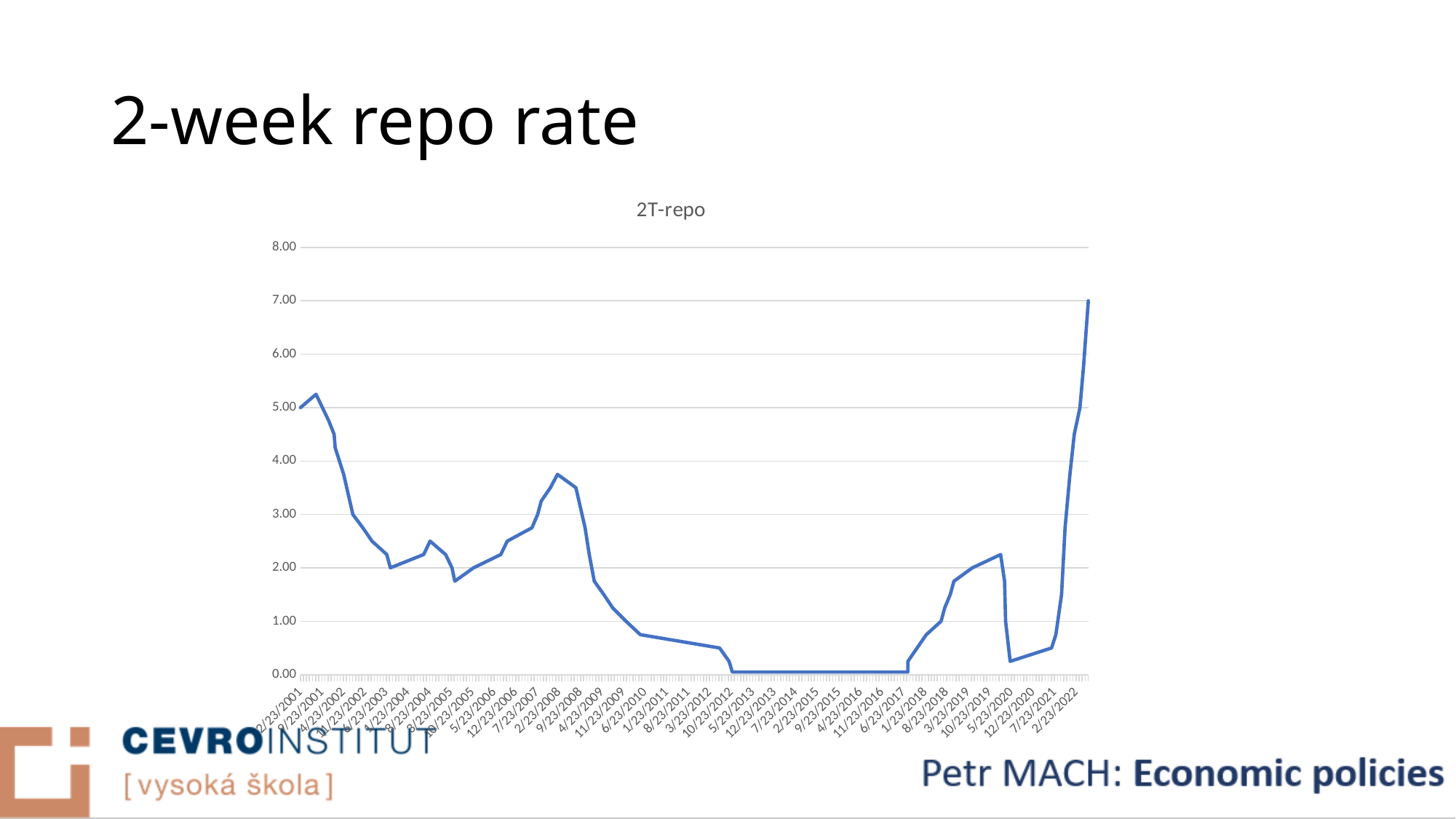
Does the line rise or fall between 2/23/2001 and 10/23/2003? fall What is the highest value shown on the vertical axis of the chart? 8.00 Which has the lower value, 2/23/2008 or 2/23/2015? 2/23/2015 What kind of chart is shown on the slide? line chart Is the value for 2/23/2008 greater or less than 3.00? greater What is the title printed above the chart? 2T-repo Is the value for 2/23/2015 greater or less than 1.00? less Is the value for 2/23/2001 greater or less than 4.00? greater